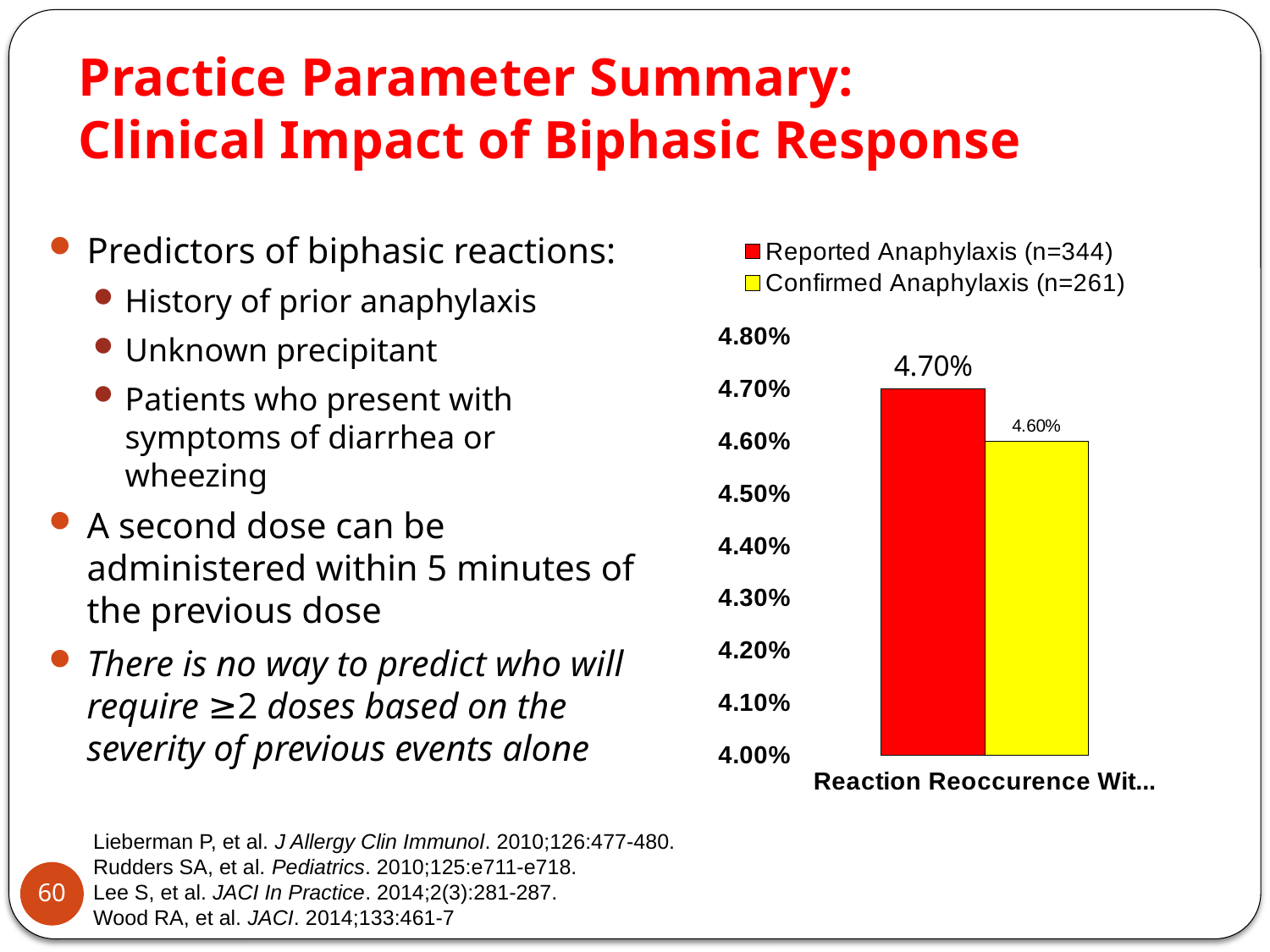
How many series does the chart legend list? 2 What colour is the bar for Reported Anaphylaxis (n=344)? red What is the difference between the Reported Anaphylaxis value and the Confirmed Anaphylaxis value? 0.10% What value is shown for Reported Anaphylaxis (n=344)? 4.70% Is the value for Reported Anaphylaxis larger or smaller than the value for Confirmed Anaphylaxis? larger Which series has the lower value, Reported Anaphylaxis or Confirmed Anaphylaxis? Confirmed Anaphylaxis What colour is the bar for Confirmed Anaphylaxis (n=261)? yellow Is the value for Reported Anaphylaxis greater or less than 4.80%? less Which series has the higher value, Reported Anaphylaxis or Confirmed Anaphylaxis? Reported Anaphylaxis What value is shown for Confirmed Anaphylaxis (n=261)? 4.60% What kind of chart is shown on the slide? bar chart Is the value for Confirmed Anaphylaxis greater or less than 4.50%? greater